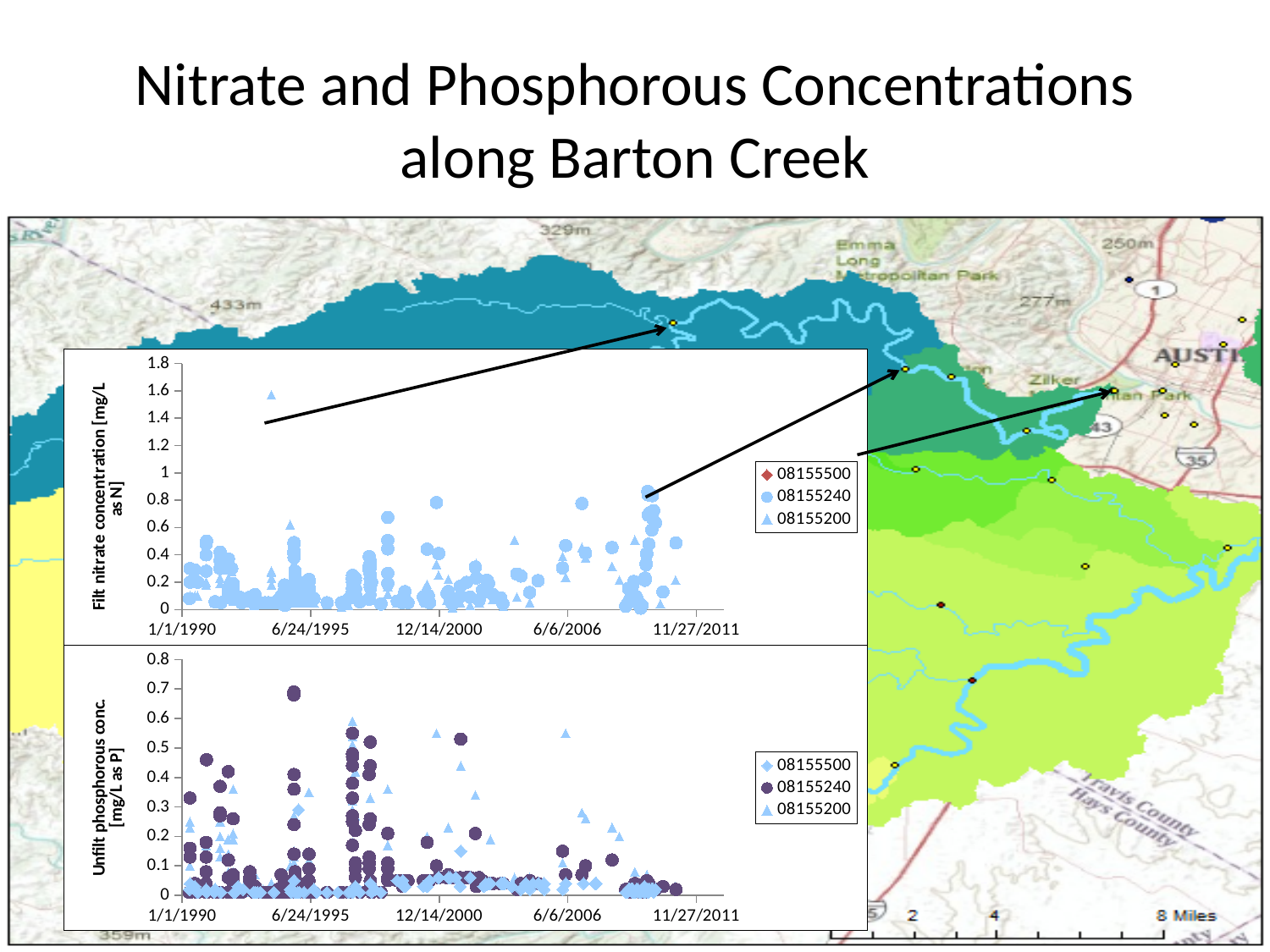
In the bottom chart (Unfilt phosphorous conc.), is the highest plotted value greater or less than 0.6? greater What is the last date label on the x axis of the bottom chart (Unfilt phosphorous conc.)? 11/27/2011 How many series does the legend of the bottom chart (Unfilt phosphorous conc.) list? 3 In the top chart (Filt nitrate concentration), what is the maximum value shown on the y axis? 1.8 What is the first date label on the x axis of the top chart (Filt nitrate concentration)? 1/1/1990 In the top chart (Filt nitrate concentration), is the highest plotted value greater or less than 1.4? greater How many date tick labels are shown on the x axis of the bottom chart (Unfilt phosphorous conc.)? 5 How many series does the legend of the top chart (Filt nitrate concentration) list? 3 What kind of chart is the top chart (Filt nitrate concentration)? scatter chart What kind of chart is the bottom chart (Unfilt phosphorous conc.)? scatter chart